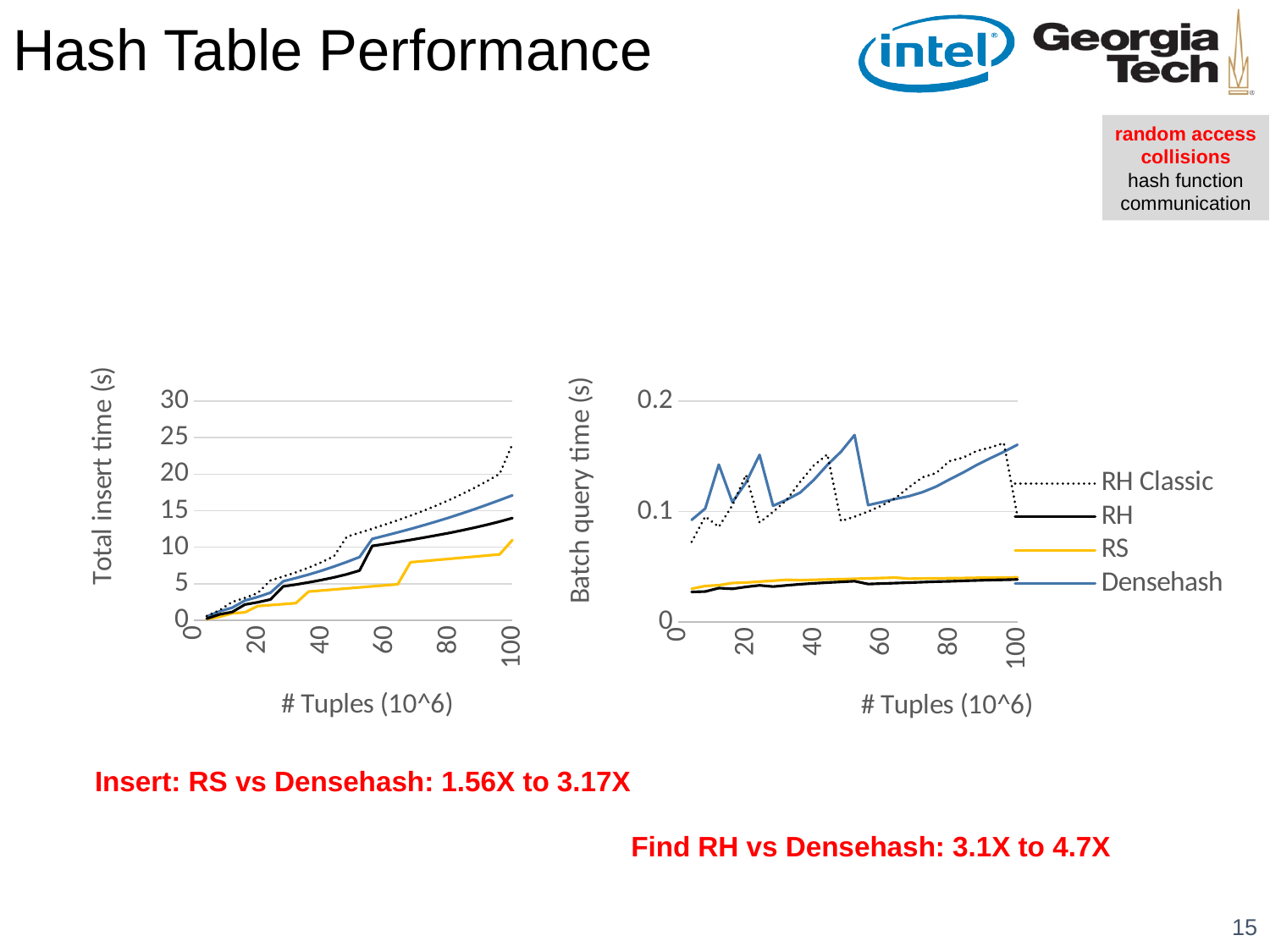
In the left chart (Total insert time), do the values for Densehash rise or fall as the number of tuples increases? rise In the right chart (Batch query time), which series has the highest value at 100 tuples? Densehash In the left chart (Total insert time), is the value for RH Classic at 100 tuples greater or less than 20? greater What is the x-axis title of the left chart? # Tuples (10^6) In the left chart (Total insert time), which series has the highest value at 100 tuples? RH Classic What kind of chart is the right chart, titled 'Batch query time (s)'? line chart In the right chart (Batch query time), is the value for RS at 100 tuples greater or less than 0.1? less In the left chart (Total insert time), is the value for Densehash at 100 tuples greater or less than 20? less In the left chart (Total insert time), which series has the lowest value at 100 tuples? RS How many series does the legend list for the charts on the slide? 4 What kind of chart is the left chart, titled 'Total insert time (s)'? line chart In the right chart (Batch query time), which is larger at 100 tuples, Densehash or RH Classic? Densehash